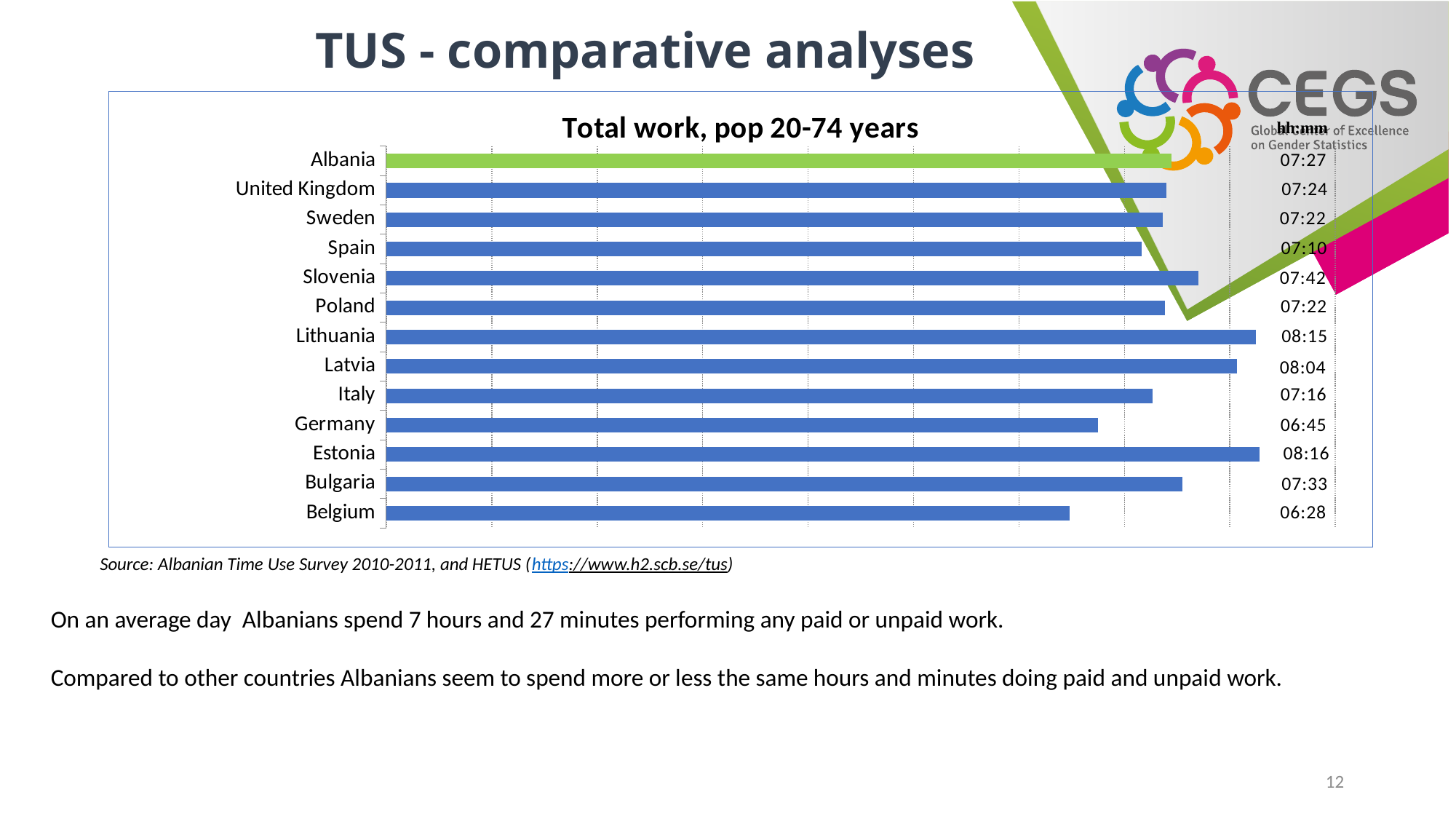
What is the value shown for Bulgaria? 07:33 Which country has the lowest total work time? Belgium How many countries are shown in the chart? 13 Which country's bar is coloured green rather than blue? Albania How many minutes longer is Albania's total work time than the United Kingdom's? 3 minutes What is the total work time for Albania? 07:27 What is the total work time shown for Lithuania? 08:15 Which country has the highest total work time? Estonia Which has a higher total work time, Slovenia or Spain? Slovenia What is the difference between Lithuania's and Latvia's total work time? 11 minutes What type of chart is shown on the slide? Bar chart What is the value shown for Germany? 06:45